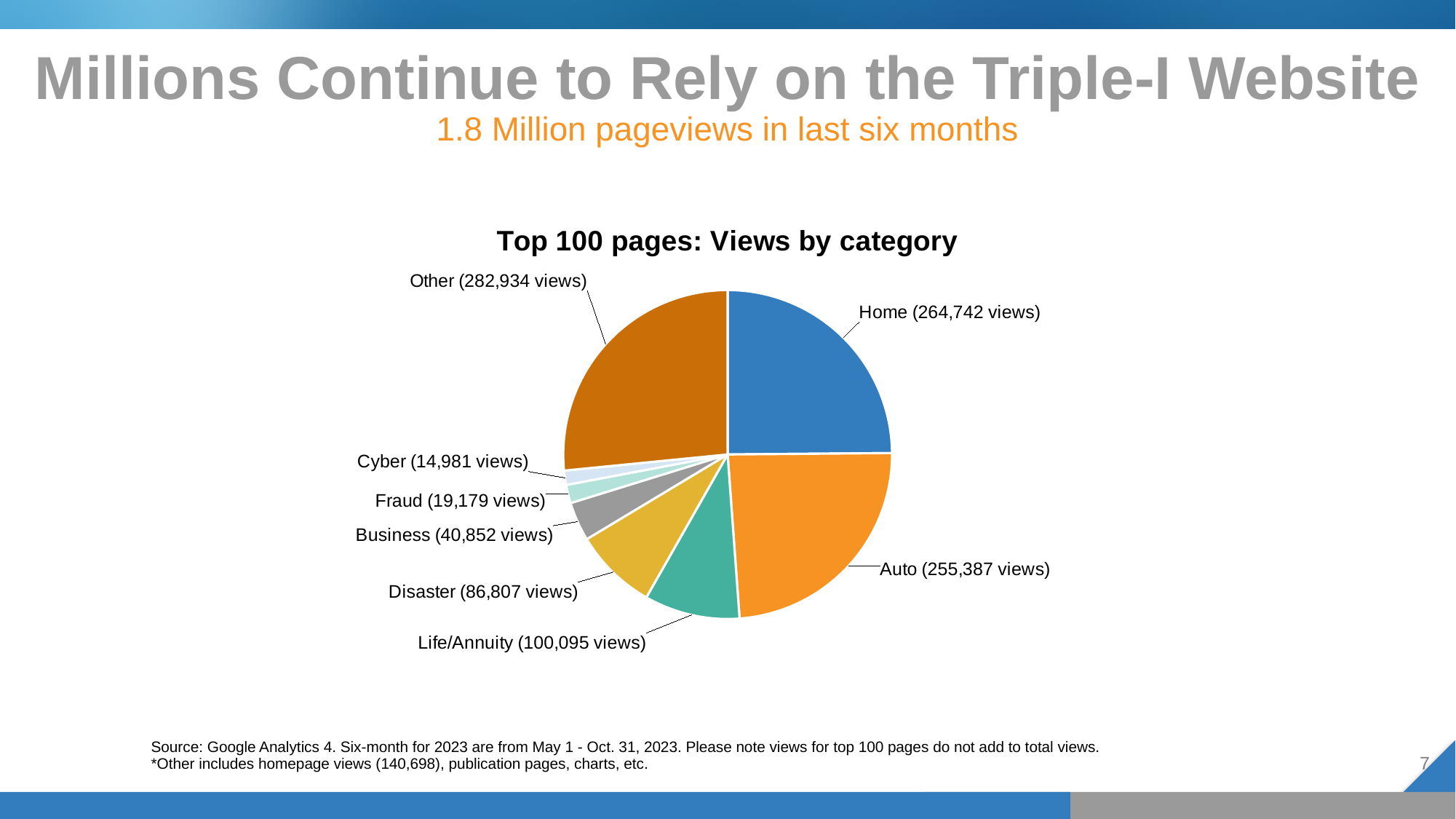
What is the title of the chart? Top 100 pages: Views by category Which category has the fewest views? Cyber How many views does the Home category have? 264,742 views What is the difference in views between Other and Home? 18,192 Which has more views, Home or Auto? Home What kind of chart is shown on the slide? pie chart How many categories does the pie chart show? 8 Which category has the most views? Other Which has more views, Disaster or Business? Disaster How many views does the Business category have? 40,852 views How many views does the Life/Annuity category have? 100,095 views What is the difference in views between Fraud and Cyber? 4,198